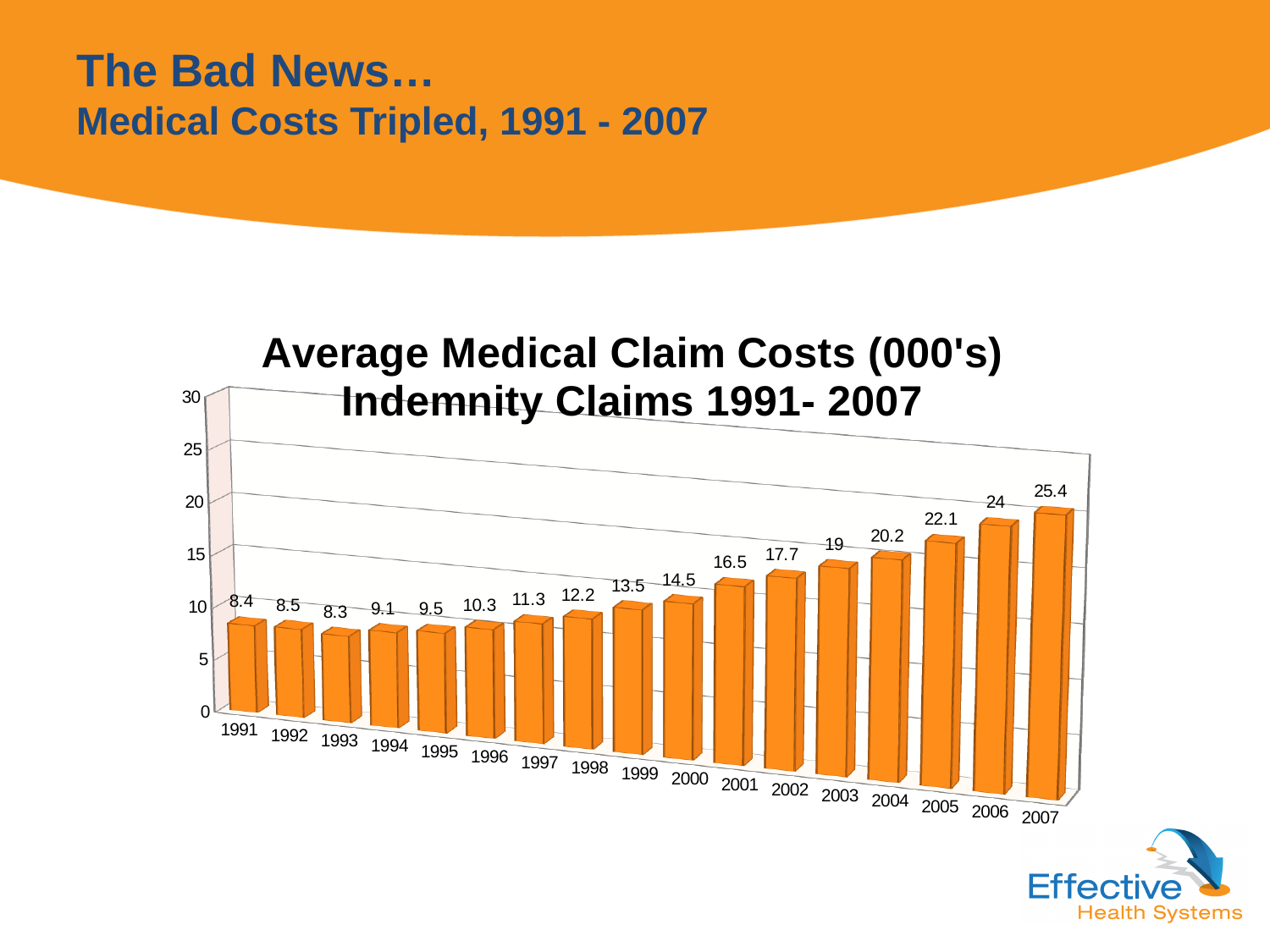
Which year has the highest average medical claim cost? 2007 What is the average medical claim cost for 2000? 14.5 What is the title of the chart? Average Medical Claim Costs (000's) Indemnity Claims 1991- 2007 Which year has a higher average medical claim cost, 2003 or 2005? 2005 What is the difference between the average medical claim cost in 2007 and in 1991? 17 How many years are shown on the x axis of the chart? 17 Is the value for 2004 greater or less than 15? greater What is the average medical claim cost for 2007? 25.4 Which year has the lowest average medical claim cost? 1993 Do the average medical claim costs generally rise or fall from 1991 to 2007? rise What is the average medical claim cost for 1991? 8.4 What kind of chart is shown on the slide? bar chart